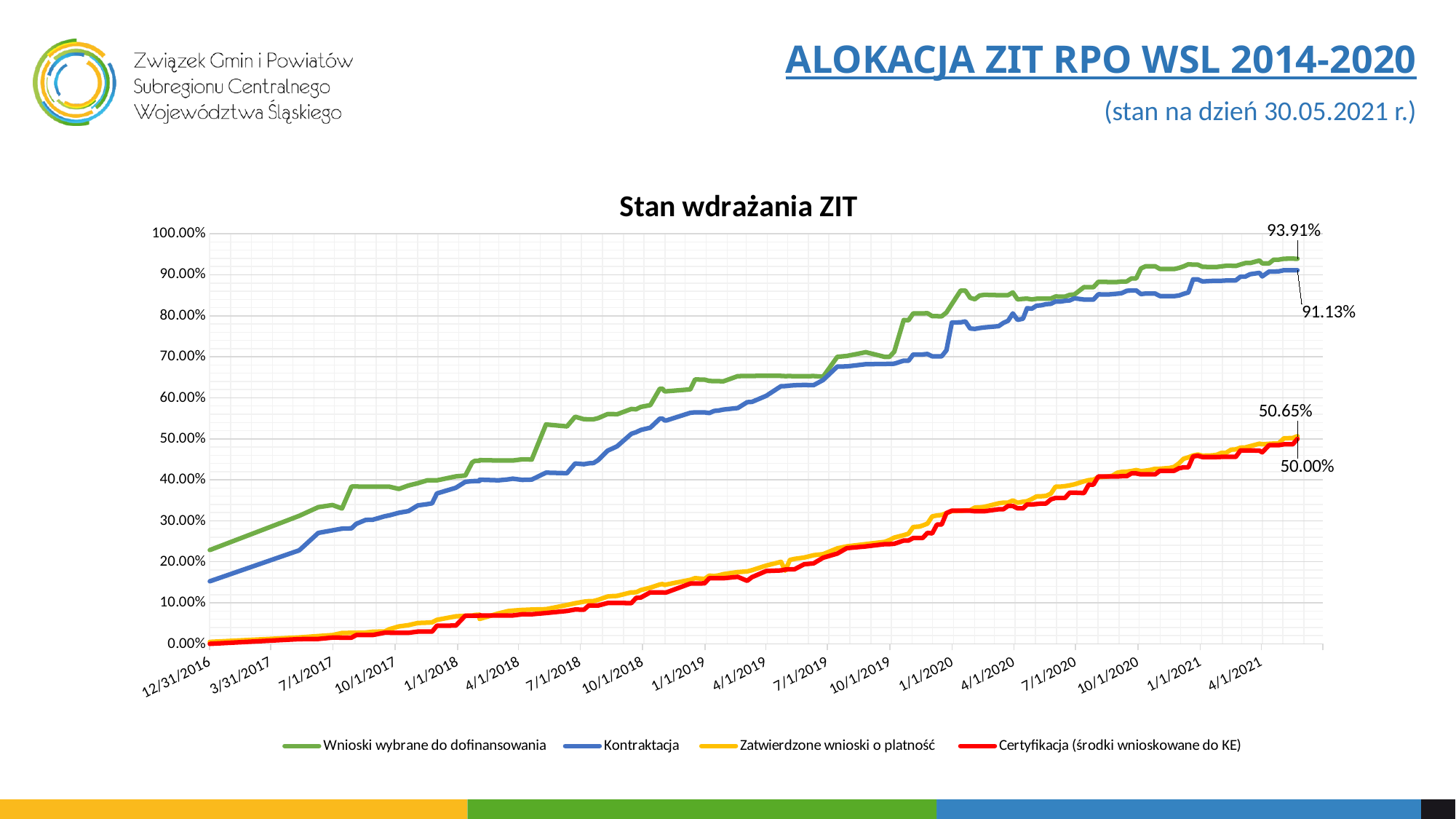
What is the final labelled value for the series 'Wnioski wybrane do dofinansowania'? 93.91% What is the final labelled value for the series 'Zatwierdzone wnioski o platność'? 50.65% What is the difference between the final labelled values of 'Wnioski wybrane do dofinansowania' and 'Kontraktacja'? 2.78% Which series has the lowest final labelled value? Certyfikacja (środki wnioskowane do KE) What is the title of the chart? Stan wdrażania ZIT How many series does the legend list? 4 Is the value of the 'Certyfikacja (środki wnioskowane do KE)' series at 1/1/2020 greater or less than 40.00%? less Which series has the highest final labelled value? Wnioski wybrane do dofinansowania What kind of chart is shown on the slide? line chart What is the final labelled value for the series 'Certyfikacja (środki wnioskowane do KE)'? 50.00% What is the final labelled value for the series 'Kontraktacja'? 91.13% Do the values of the 'Kontraktacja' series rise or fall over time along the x axis? rise